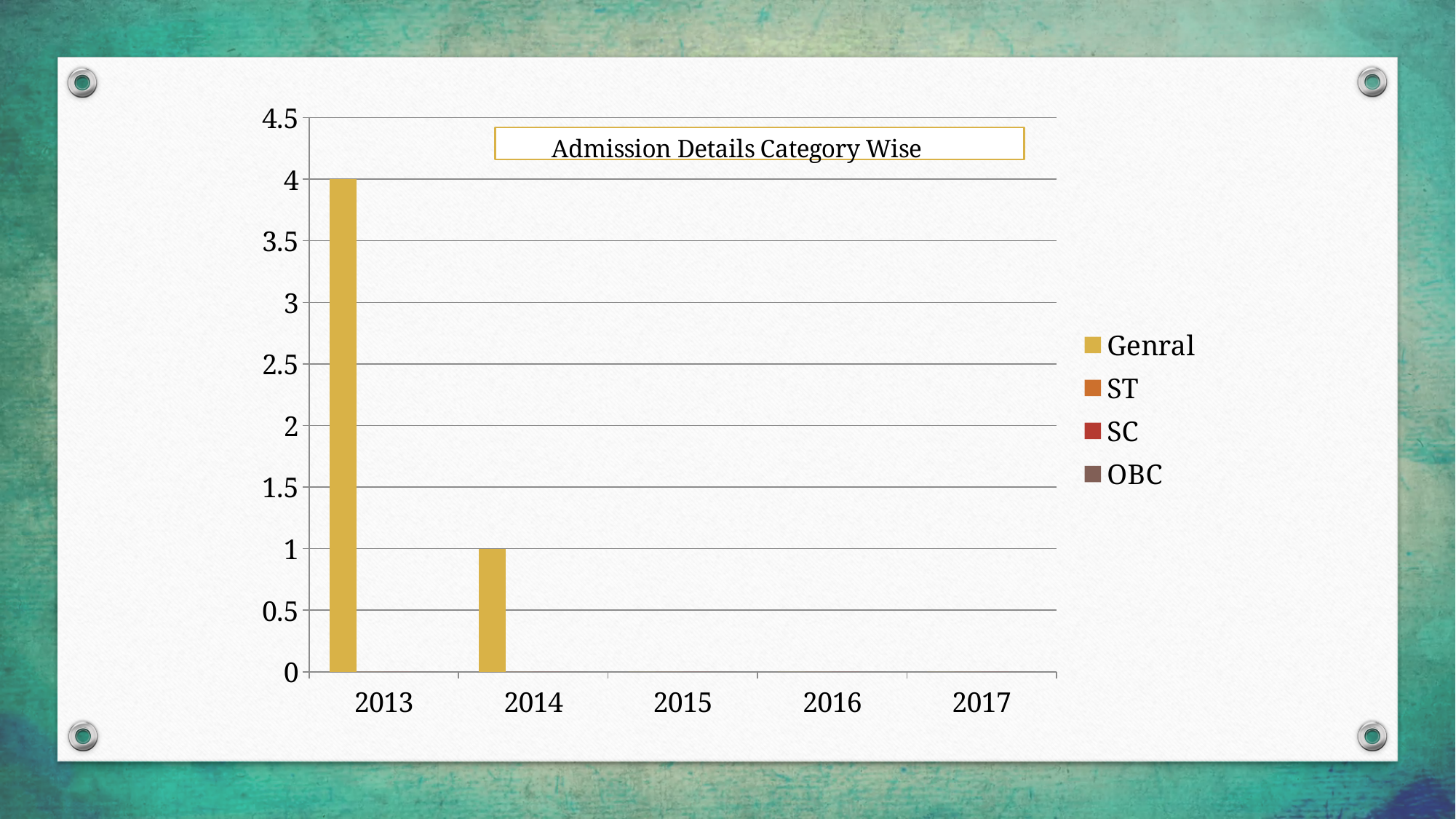
What is the Genral value for 2013? 4 What is the Genral value for 2014? 1 What is the difference between the Genral values for 2013 and 2014? 3 How many series does the legend list? 4 Is the Genral value for 2013 greater or less than 3? greater How many years are shown on the x axis? 5 What is the title of the chart? Admission Details Category Wise Which year has the highest Genral value? 2013 What kind of chart is shown on the slide? bar chart Which legend entry is shown in yellow? Genral Does the Genral value rise or fall from 2013 to 2014? fall Which is larger, the Genral value for 2013 or for 2014? 2013